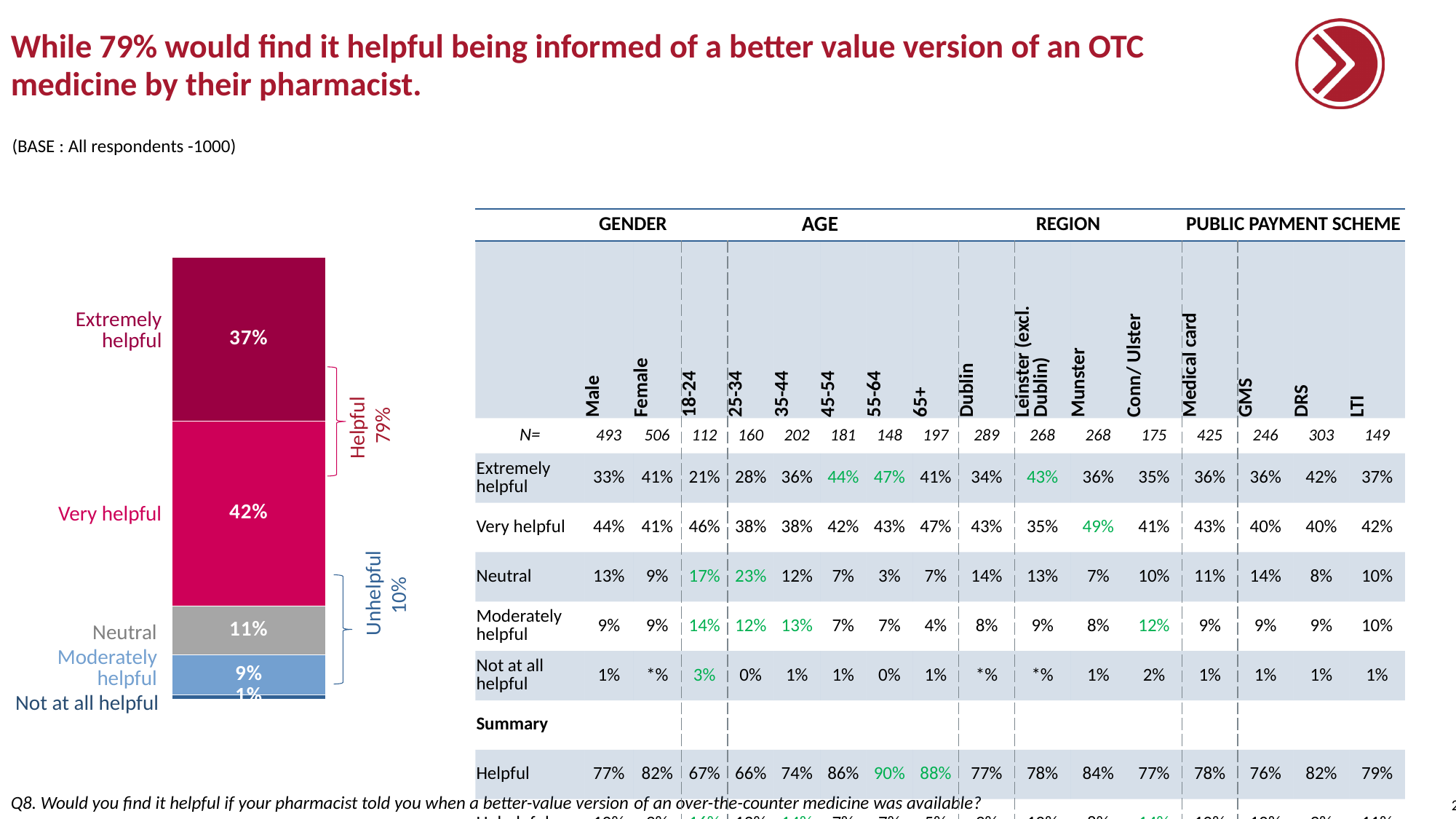
What is the difference between the 'Very helpful' and 'Extremely helpful' percentages? 5% Which response category has the smallest share in the stacked bar? Not at all helpful What percentage of respondents said it would be very helpful? 42% What percentage of respondents said it would be not at all helpful? 1% How many response categories are shown in the stacked bar? 5 What percentage of respondents said it would be extremely helpful? 37% What percentage of respondents said it would be moderately helpful? 9% What type of chart is shown on the left of the slide? Stacked bar chart Which response category has the largest share in the stacked bar? Very helpful What combined percentage is labelled 'Helpful' next to the stacked bar? 79% Which is larger, the 'Neutral' share or the 'Moderately helpful' share? Neutral What percentage of respondents were neutral? 11%